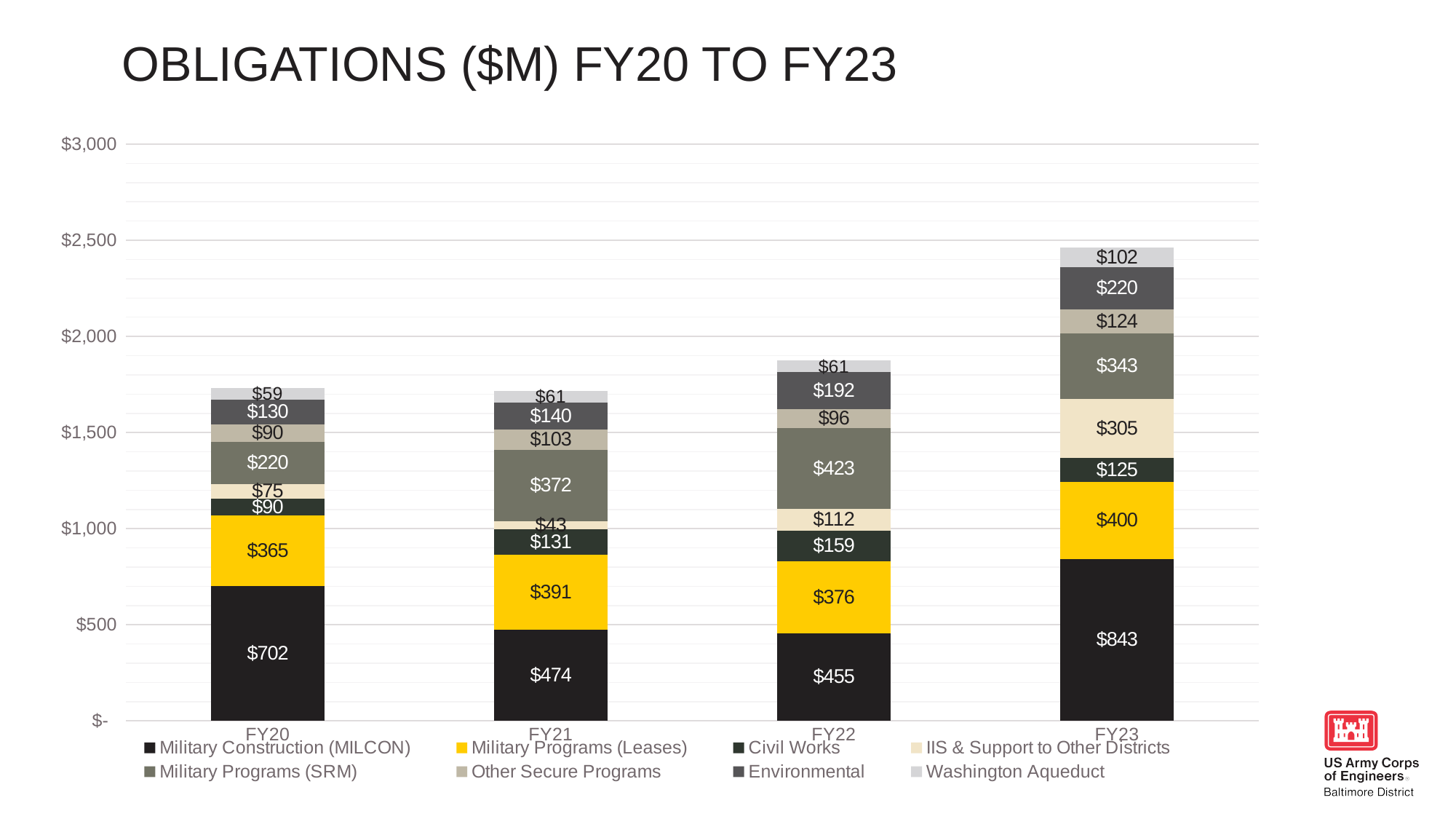
What is the value for Military Construction (MILCON) in FY23? $843 Which is larger, the Military Programs (Leases) value in FY21 or in FY22? FY21 How many series does the legend list? 8 What kind of chart is shown on the slide? Stacked bar chart What is the difference between the Environmental value in FY23 and in FY20? $90 In which fiscal year is the Military Construction (MILCON) value highest? FY23 What is the value for Washington Aqueduct in FY20? $59 How many fiscal years are shown on the x axis? 4 Is the total of the FY23 stacked bar greater or less than $2,000? greater In which fiscal year is the Civil Works value lowest? FY20 What is the value for Military Programs (SRM) in FY22? $423 What is the total of the FY23 stacked bar? $2,462